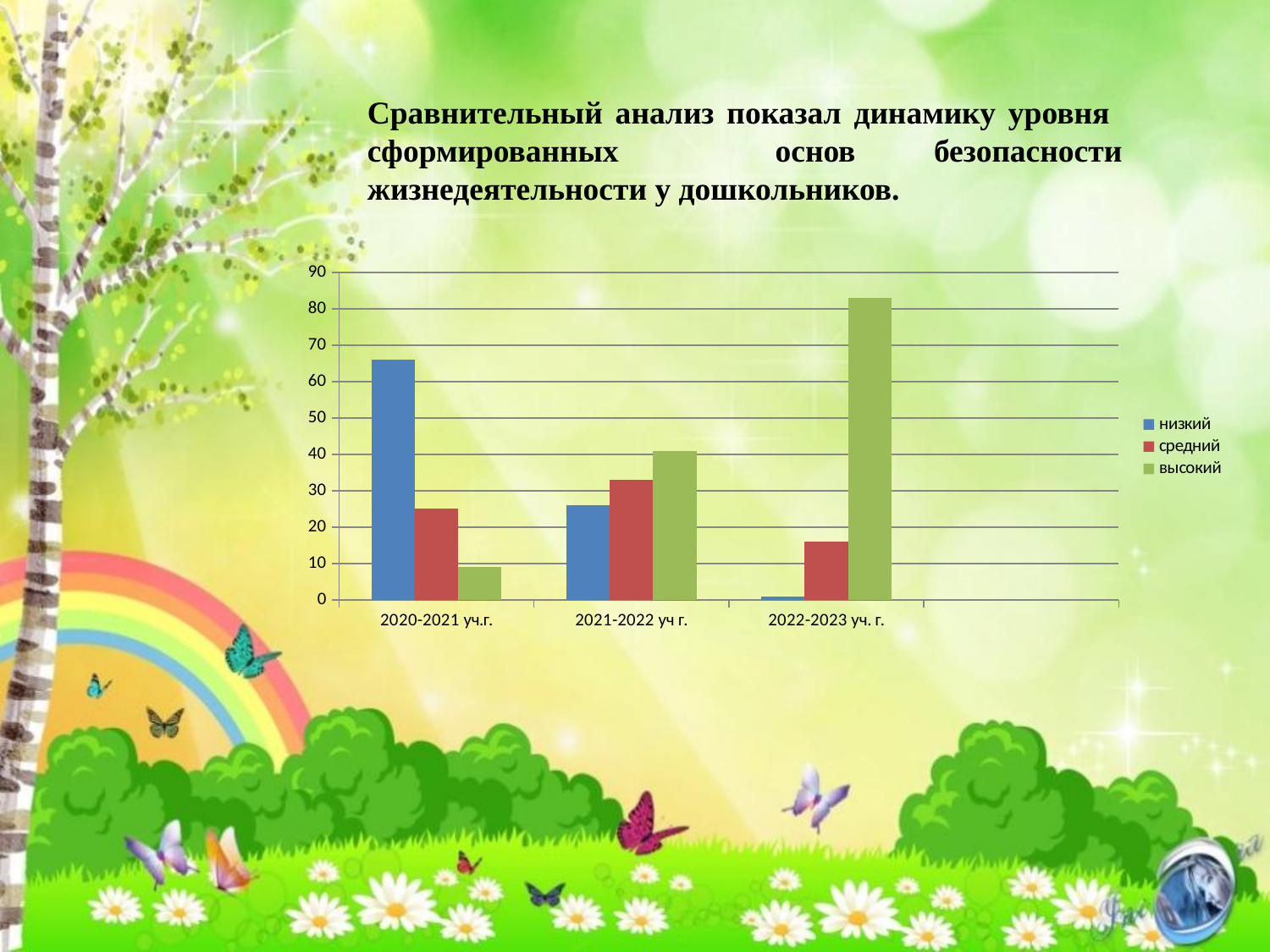
Which series has the lowest value in 2022-2023 уч. г.? низкий Is the value for высокий in 2022-2023 уч. г. greater or less than 80? greater Which is larger in 2021-2022 уч г.: средний or низкий? средний Is the value for высокий in 2020-2021 уч.г. greater or less than 10? less What colour represents the series средний in the legend? red How many categories (school years) are shown on the x axis? 3 Is the value for низкий in 2020-2021 уч.г. greater or less than 60? greater How many series does the legend list? 3 What kind of chart is shown on the slide? bar chart Which series has the highest value in 2022-2023 уч. г.? высокий Does the value for высокий rise or fall across the school years from 2020-2021 to 2022-2023? rise Which series has the highest value in 2020-2021 уч.г.? низкий